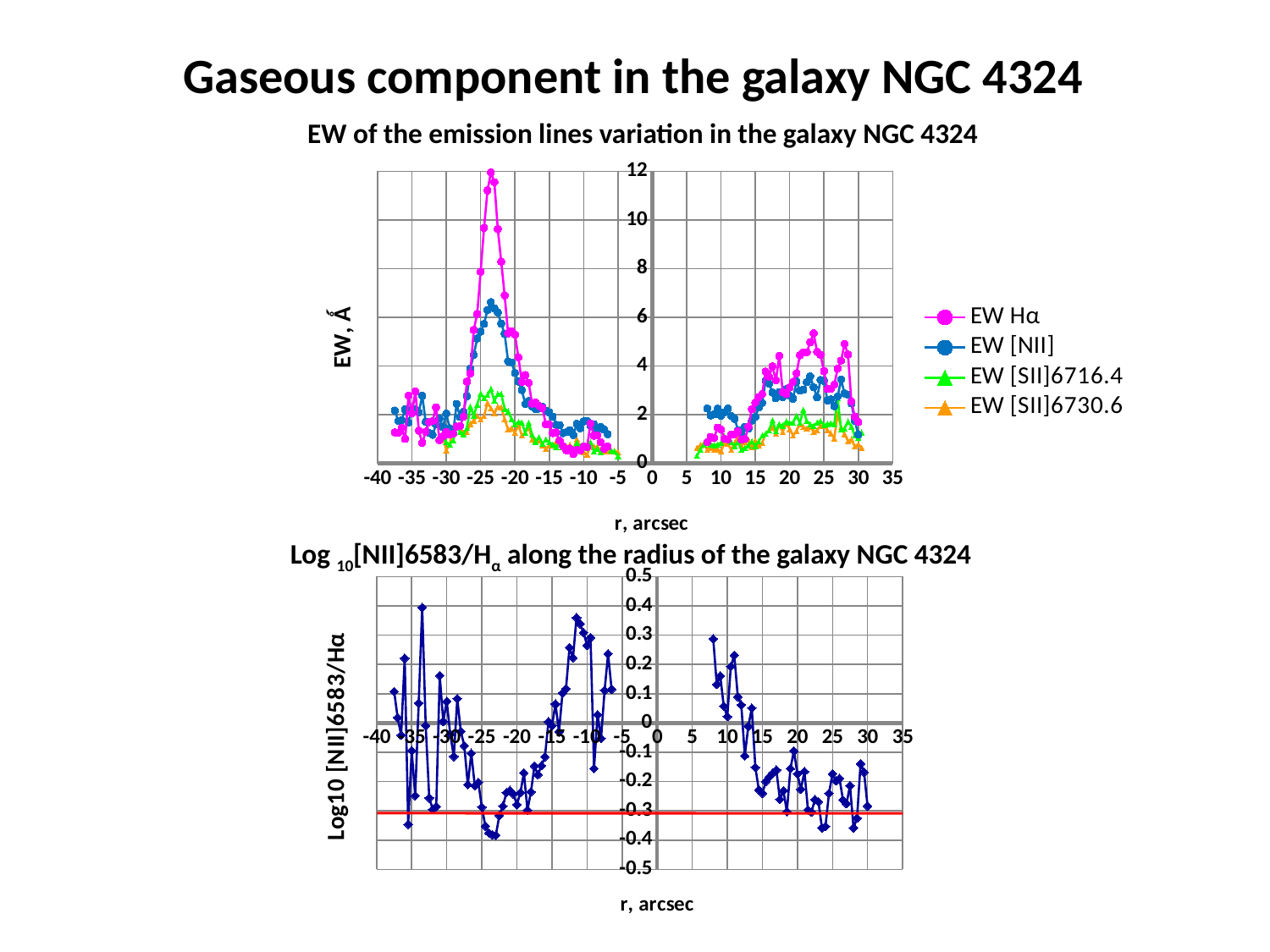
What is the y-axis label of the top chart? EW, Å In the bottom chart, is the lowest value, near r = -25 arcsec, greater or less than -0.3? less In the top chart, which series reaches the highest value? EW Hα What kind of chart is the bottom chart, 'Log10[NII]6583/Hα along the radius of the galaxy NGC 4324'? line chart What kind of chart is the top chart, 'EW of the emission lines variation in the galaxy NGC 4324'? line chart How many series does the legend of the top chart list? 4 In the top chart, is the peak value of EW [NII] near r = -23 arcsec greater or less than 8? less In the top chart, is the maximum value of EW [SII]6730.6 greater or less than 4? less In the bottom chart, is the red horizontal line above or below 0? below In the top chart, at r = -23 arcsec, which is larger: EW Hα or EW [SII]6716.4? EW Hα